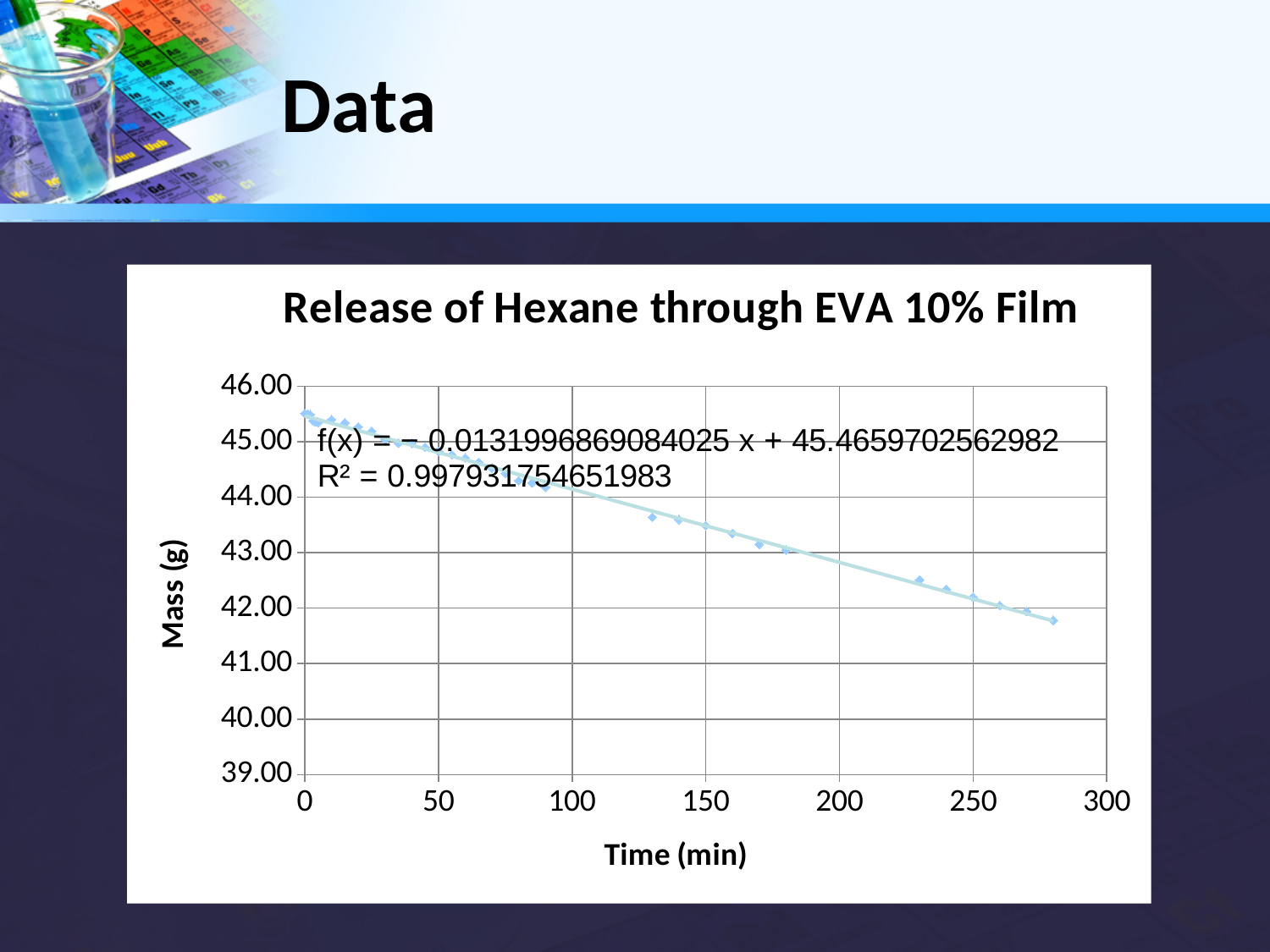
Is the mass at time 280 min greater or less than 42.00? less What kind of chart is shown on the slide? scatter chart What is the title of the chart? Release of Hexane through EVA 10% Film Which is larger, the mass at 0 min or the mass at 280 min? 0 min At which time is the mass highest? 0 min Is the mass at time 50 min greater or less than 44.00? greater At which time is the mass lowest? 280 min Is the mass at time 230 min greater or less than 43.00? less Does the mass rise or fall as time increases along the x axis? fall What R² value is printed on the chart? R² = 0.997931754651983